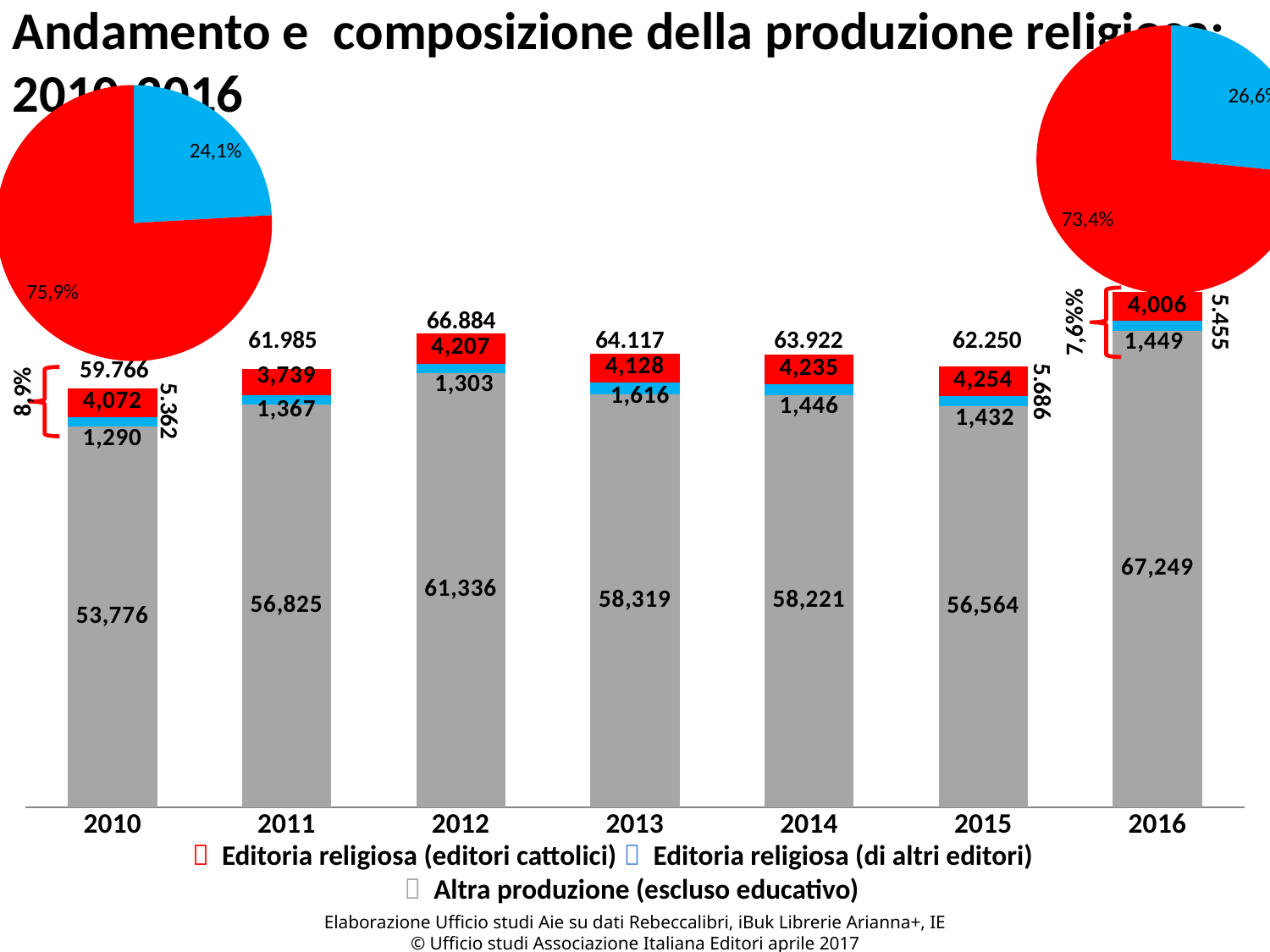
In the stacked bar chart, what is the value of Editoria religiosa (editori cattolici) for 2012? 4,207 In the stacked bar chart, is the Editoria religiosa (di altri editori) value larger in 2013 or in 2014? 2013 In the pie chart on the left, what share does the red slice represent? 75,9% In the stacked bar chart, which year has the highest value for Altra produzione (escluso educativo)? 2016 How many years are shown on the x axis of the stacked bar chart? 7 In the stacked bar chart, what is the value of Altra produzione (escluso educativo) for 2016? 67,249 In the stacked bar chart, which year has the highest value for Editoria religiosa (di altri editori)? 2013 What kind of chart is the main chart showing the years 2010 to 2016? Stacked bar chart In the stacked bar chart, what is the value of Editoria religiosa (di altri editori) for 2013? 1,616 In the stacked bar chart, which year has the lowest value for Editoria religiosa (editori cattolici)? 2011 In the stacked bar chart, what is the difference between the Altra produzione (escluso educativo) values for 2012 and 2011? 4,511 How many series does the legend of the stacked bar chart list? 3